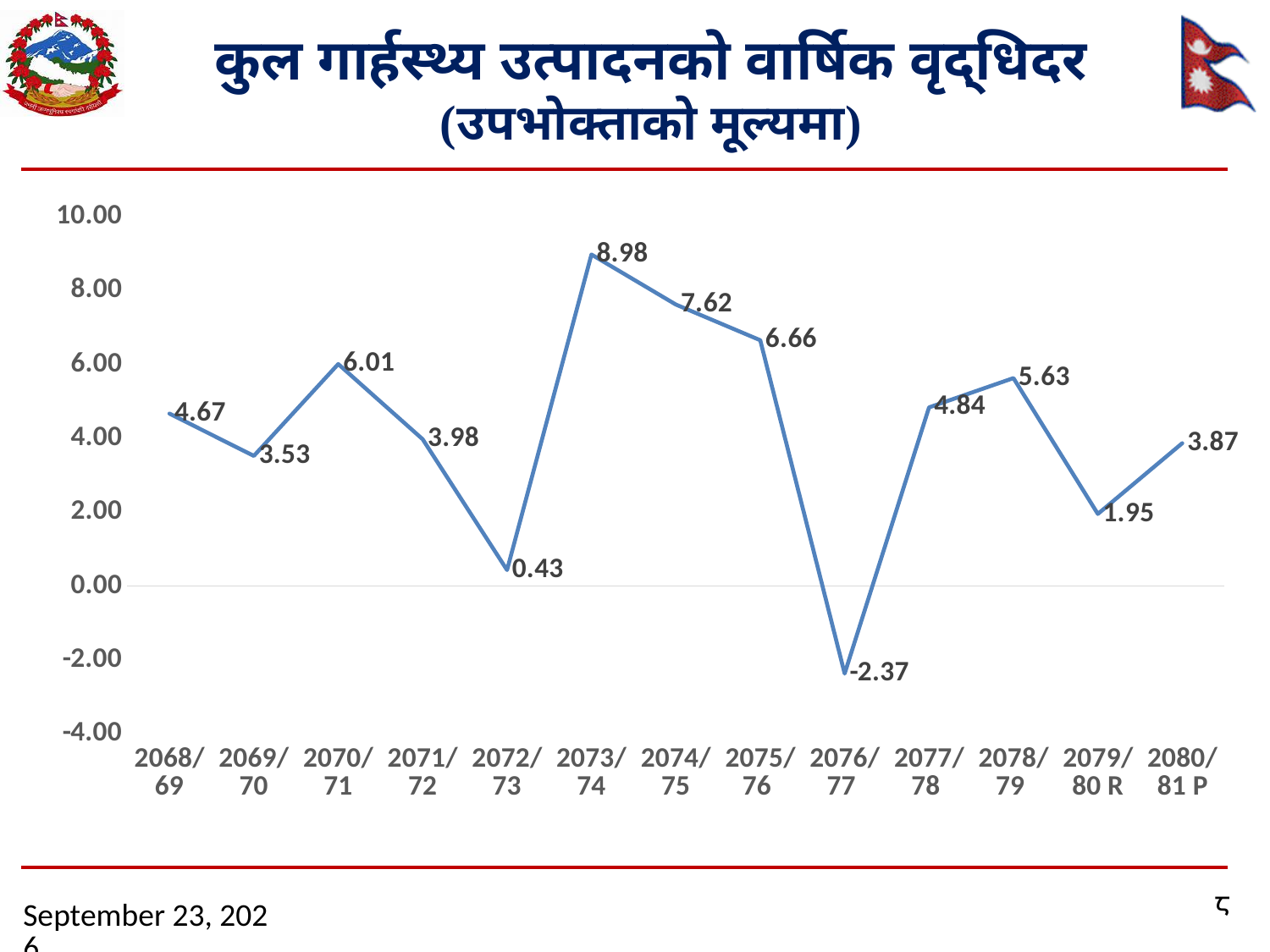
Do the values rise or fall from 2079/80 R to 2080/81 P? rise What is the difference between the values for 2077/78 and 2078/79? 0.79 Which year has the highest value? 2073/74 What is the value for 2076/77? -2.37 What is the value for 2080/81 P? 3.87 Which is larger, the value for 2070/71 or the value for 2078/79? 2070/71 What is the difference between the values for 2073/74 and 2074/75? 1.36 What is the value for 2073/74? 8.98 Which year has the lowest value? 2076/77 Is the value for 2072/73 greater or less than 2.00? less How many years are plotted on the chart? 13 What kind of chart is shown on the slide? line chart